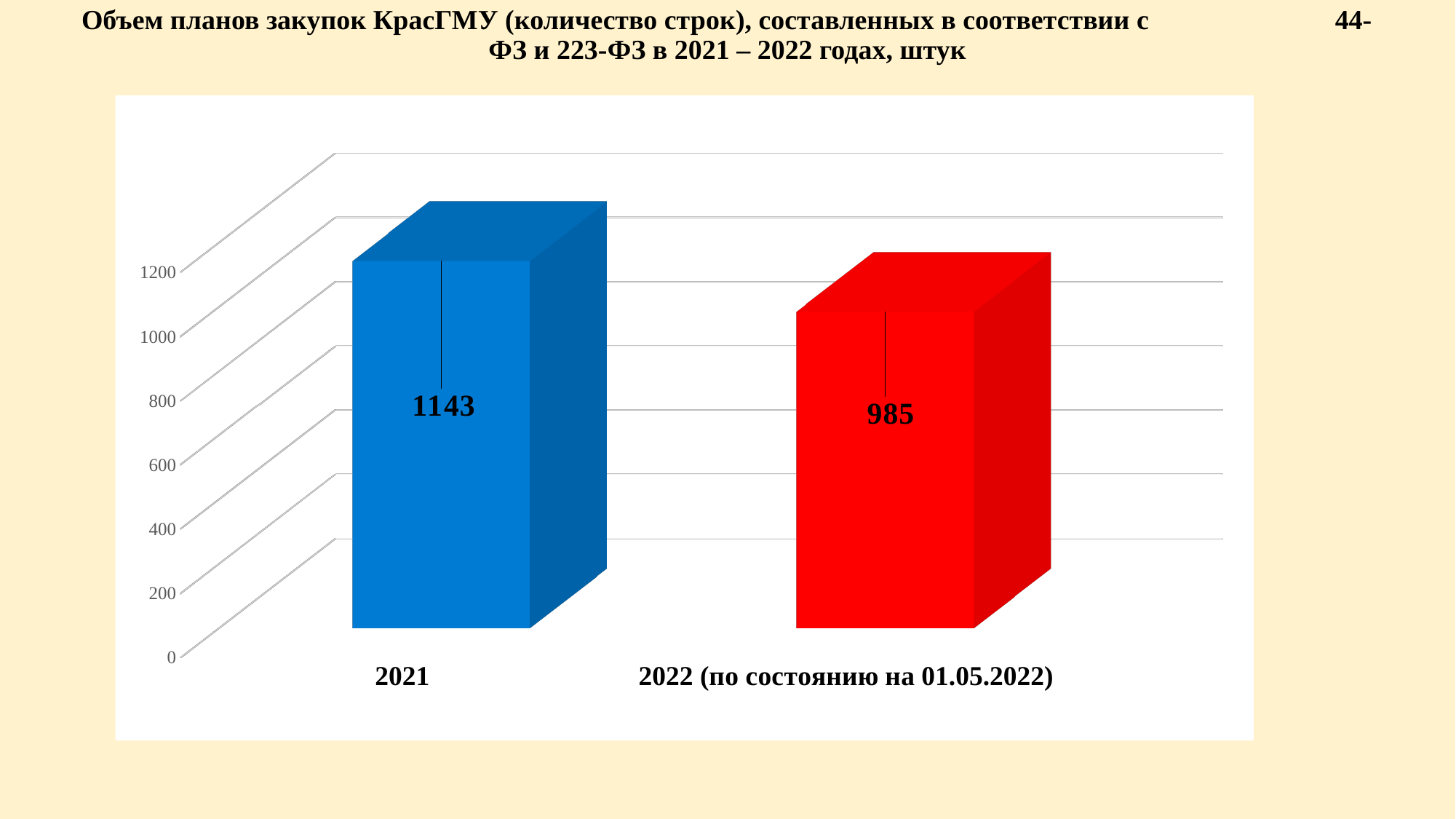
Do the values rise or fall from 2021 to 2022? fall Is the value for 2021 greater or less than 1000? greater What is the difference between the values for 2021 and 2022 (по состоянию на 01.05.2022)? 158 How many categories are shown on the x axis? 2 Is the value for 2022 (по состоянию на 01.05.2022) greater or less than 1000? less Which is larger, the value for 2021 or the value for 2022 (по состоянию на 01.05.2022)? 2021 Which category has the highest value? 2021 What is the value for 2021? 1143 What kind of chart is shown on the slide? bar chart Which category has the lowest value? 2022 (по состоянию на 01.05.2022) What is the value for 2022 (по состоянию на 01.05.2022)? 985 What colour is the bar for 2022 (по состоянию на 01.05.2022)? red